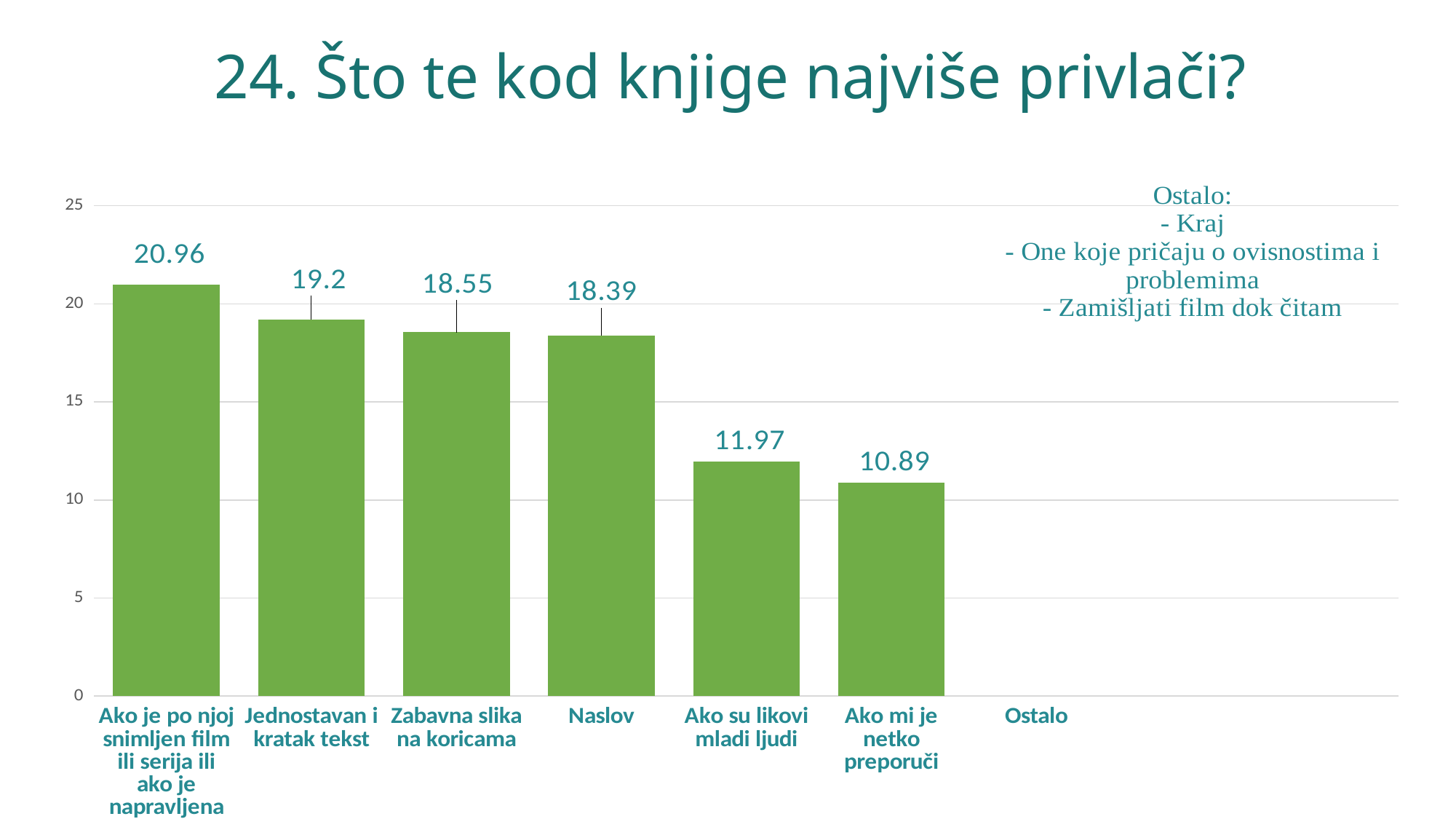
How many bars with data labels are plotted in the chart? 6 What is the difference between the values for "Ako je po njoj snimljen film ili serija ili ako je napravljena" and "Ako mi je netko preporuči"? 10.07 Is the value for "Naslov" greater or less than 15? greater Which category has the highest value? Ako je po njoj snimljen film ili serija ili ako je napravljena What is the value for "Ako su likovi mladi ljudi"? 11.97 Which is larger, the value for "Zabavna slika na koricama" or the value for "Ako su likovi mladi ljudi"? Zabavna slika na koricama What kind of chart is shown on the slide? bar chart What is the difference between the values for "Ako su likovi mladi ljudi" and "Ako mi je netko preporuči"? 1.08 Which of the labelled bars has the lowest value? Ako mi je netko preporuči Do the bar values rise or fall from left to right along the x axis? fall What is the value for "Jednostavan i kratak tekst"? 19.2 What is the value for "Naslov"? 18.39